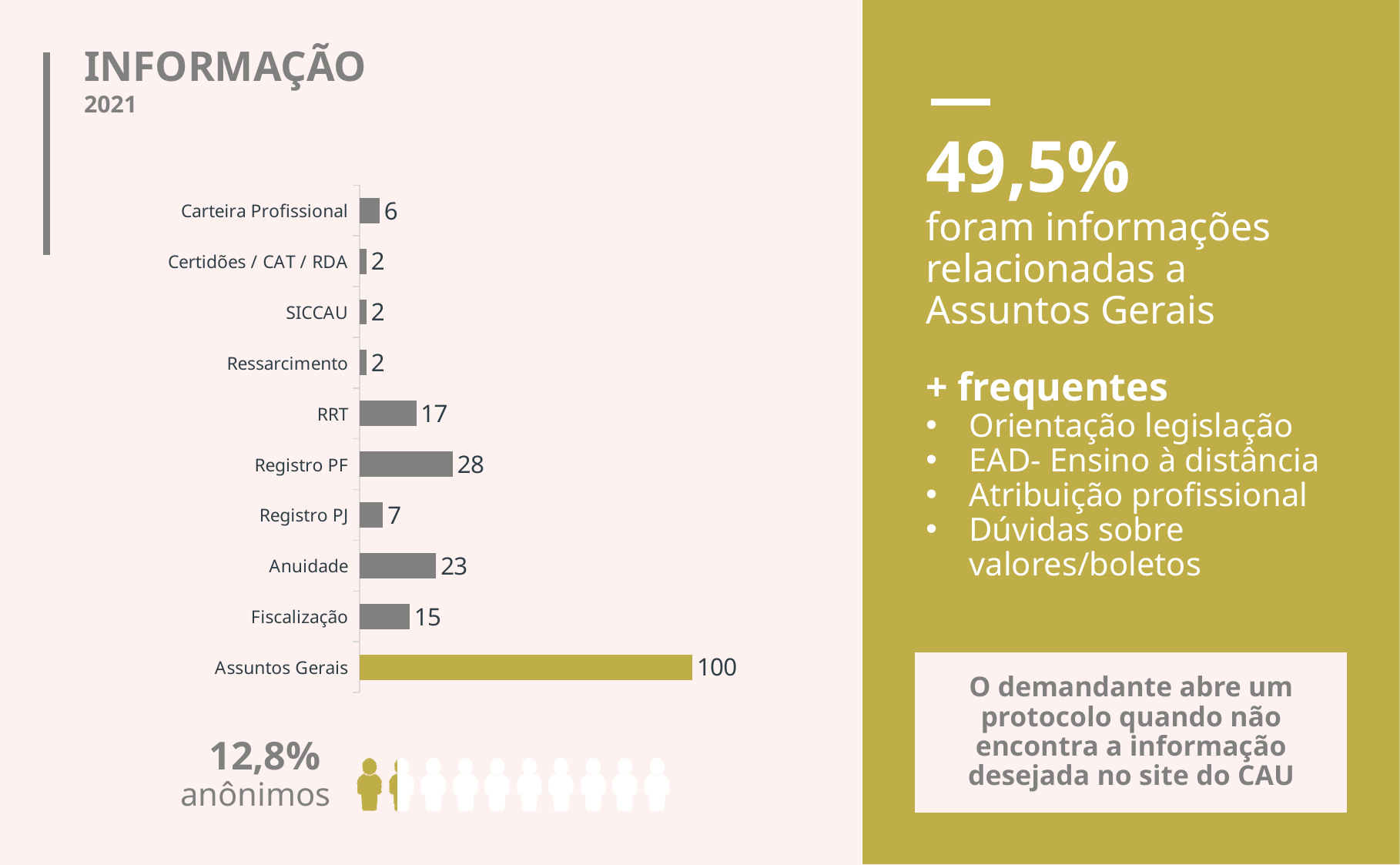
What is the value for Anuidade? 23 How many categories have a value of 2? 3 What is the difference between the values for Registro PF and Registro PJ? 21 What kind of chart is shown on the slide? Bar chart Which bar is shown in a different colour from the others? Assuntos Gerais What is the value for Assuntos Gerais? 100 What is the value for Registro PF? 28 Which is larger, the value for Anuidade or the value for Fiscalização? Anuidade What is the difference between the values for Assuntos Gerais and Registro PF? 72 What is the value for RRT? 17 How many categories are shown in the chart? 10 Which category has the highest value? Assuntos Gerais